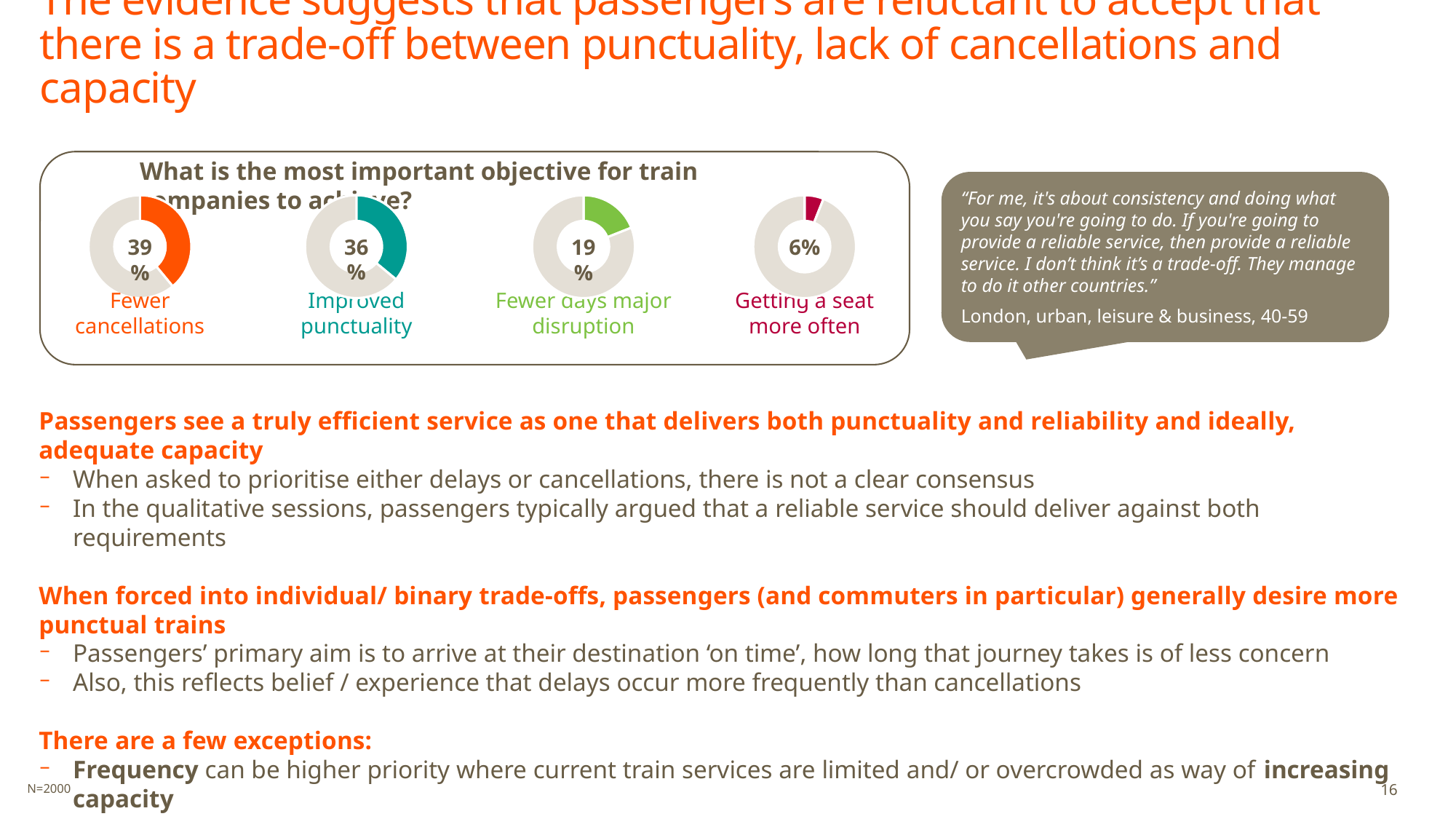
What kind of chart is used to show the share for each objective? Donut (pie) chart What colour is the donut segment for 'Improved punctuality'? Teal Which objective has the lowest share in the donut charts? Getting a seat more often Which has a larger share: 'Improved punctuality' or 'Fewer days major disruption'? Improved punctuality How many objectives are shown in the donut charts? 4 What percentage of passengers chose 'Fewer cancellations' as the most important objective for train companies? 39% What percentage of passengers chose 'Getting a seat more often' as the most important objective? 6% What is the difference in percentage points between 'Fewer days major disruption' and 'Getting a seat more often'? 13 Which objective has the highest share in the donut charts? Fewer cancellations What percentage of passengers chose 'Fewer days major disruption' as the most important objective? 19% What is the difference in percentage points between 'Fewer cancellations' and 'Improved punctuality'? 3 What percentage of passengers chose 'Improved punctuality' as the most important objective? 36%